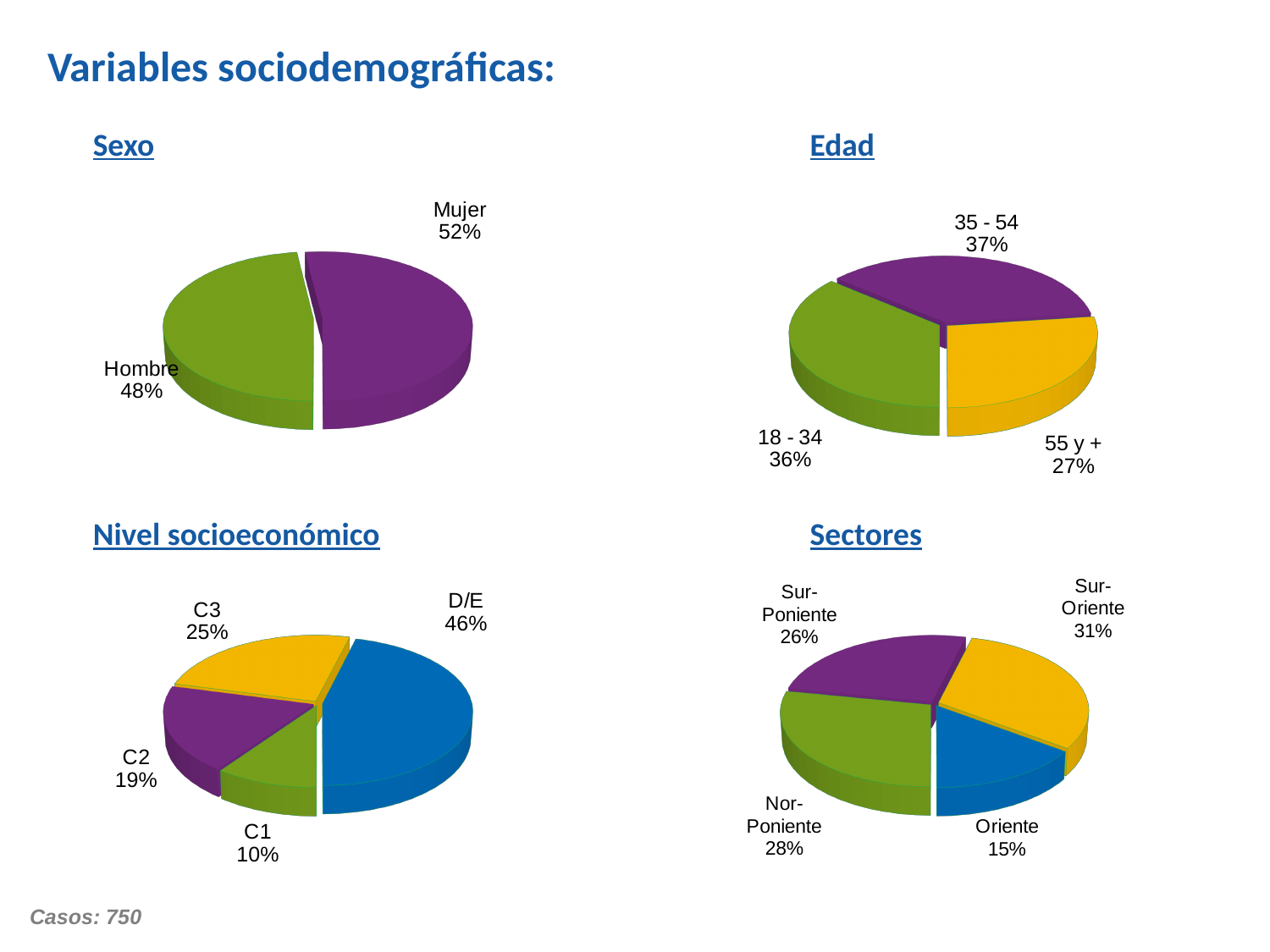
In the Nivel socioeconómico chart, what is the difference between D/E and C3? 21% In the Nivel socioeconómico chart, what percentage is C2? 19% How many slices does the Sectores chart have? 4 In the Sectores chart, which sector has the largest share? Sur-Oriente In the Sexo chart, what percentage is Mujer? 52% What kind of chart is the Sexo chart? Pie chart In the Edad chart, what percentage is the 55 y + group? 27% In the Sectores chart, which is larger, Sur-Poniente or Nor-Poniente? Nor-Poniente How many pie charts are on the slide? 4 In the Nivel socioeconómico chart, which category has the smallest share? C1 In the Edad chart, which age group has the largest share? 35 - 54 In the Sectores chart, what percentage is Oriente? 15%